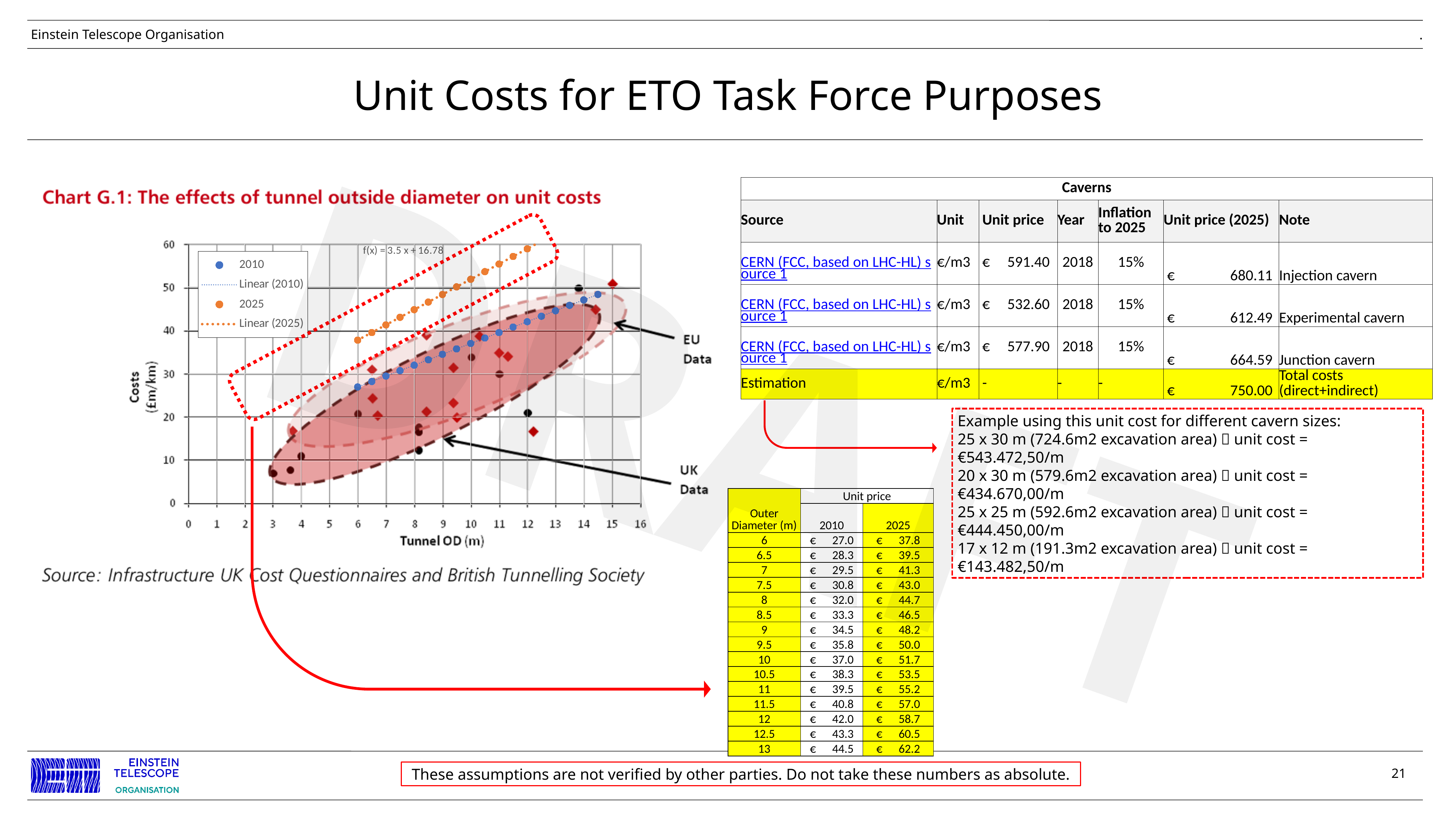
What is the linear fit equation shown on Chart G.1? f(x) = 3.5 x + 16.78 In Chart G.1, is the 2025 value at a tunnel OD of 6 m greater or less than 30? greater How many entries does the legend of Chart G.1 list? 4 According to the unit price table linked to Chart G.1, what is the 2025 unit price for an outer diameter of 10 m? € 51.7 In Chart G.1, do the 2025 costs rise or fall as tunnel OD increases? rise In Chart G.1, is the 2010 value at a tunnel OD of 14 m greater or less than 40? greater What is the label of the y axis of Chart G.1? Costs (£m/km) In Chart G.1, is the 2010 value at a tunnel OD of 6 m greater or less than 30? less What kind of chart is Chart G.1 on the slide? scatter chart In Chart G.1, do the 2010 costs rise or fall as tunnel OD increases? rise In Chart G.1, at a tunnel OD of 10 m, which series has the higher cost, 2010 or 2025? 2025